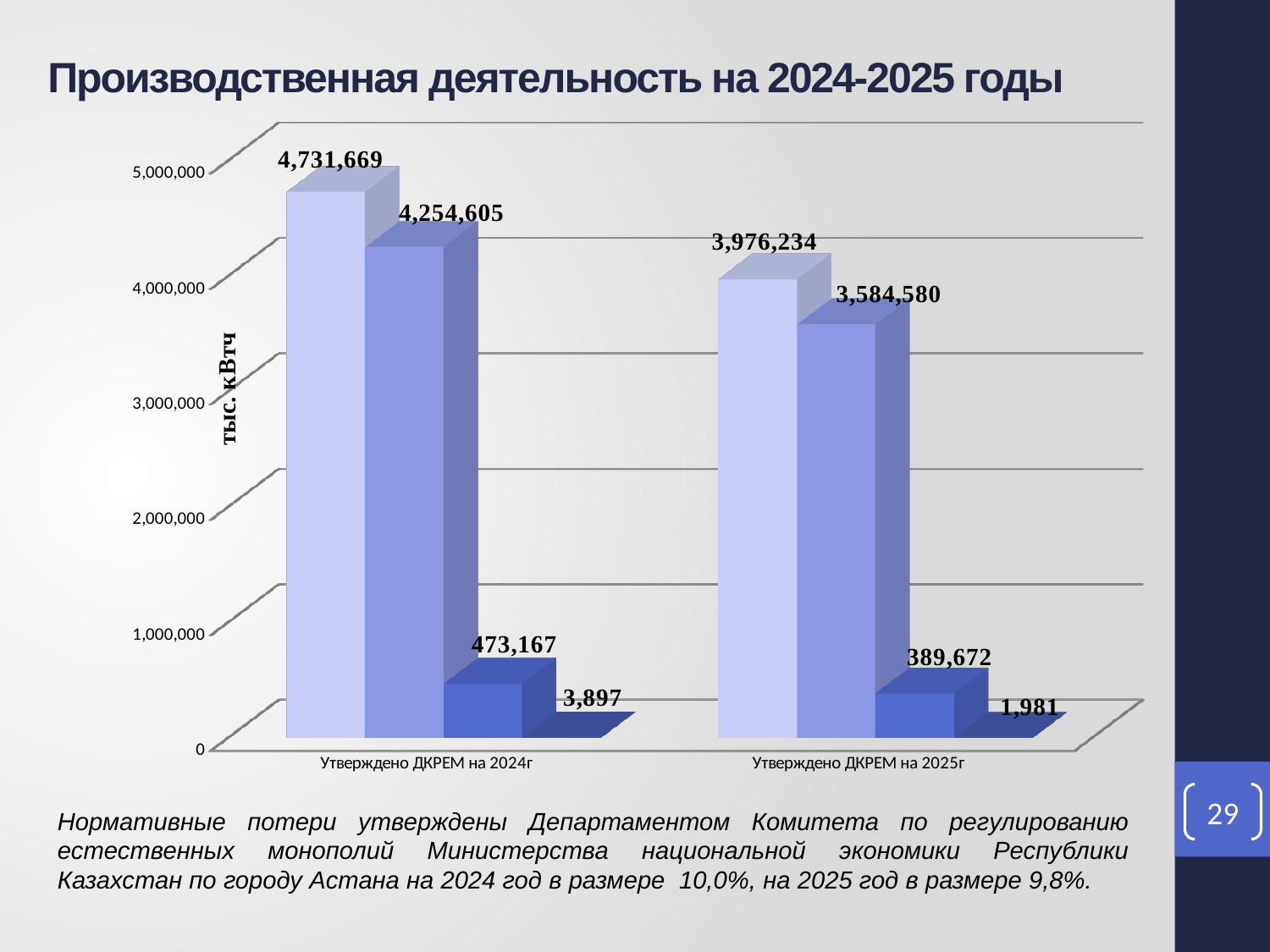
What is the value of the tallest bar for "Утверждено ДКРЕМ на 2024г"? 4,731,669 What kind of chart is shown on the slide? bar chart What is the difference between the second bar for 2024 (4,254,605) and the second bar for 2025 (3,584,580)? 670,025 What is the label on the vertical axis of the chart? тыс. кВтч How many categories are shown on the x axis of the chart? 2 What is the value of the smallest bar for "Утверждено ДКРЕМ на 2024г"? 3,897 Which is larger: the third bar for 2024 (473,167) or the third bar for 2025 (389,672)? Утверждено ДКРЕМ на 2024г How many bars are plotted for each category in the chart? 4 What is the value of the tallest bar for "Утверждено ДКРЕМ на 2025г"? 3,976,234 Which category contains the highest value in the chart? Утверждено ДКРЕМ на 2024г What is the difference between the tallest bar for 2024 (4,731,669) and the tallest bar for 2025 (3,976,234)? 755,435 What is the value of the smallest bar for "Утверждено ДКРЕМ на 2025г"? 1,981